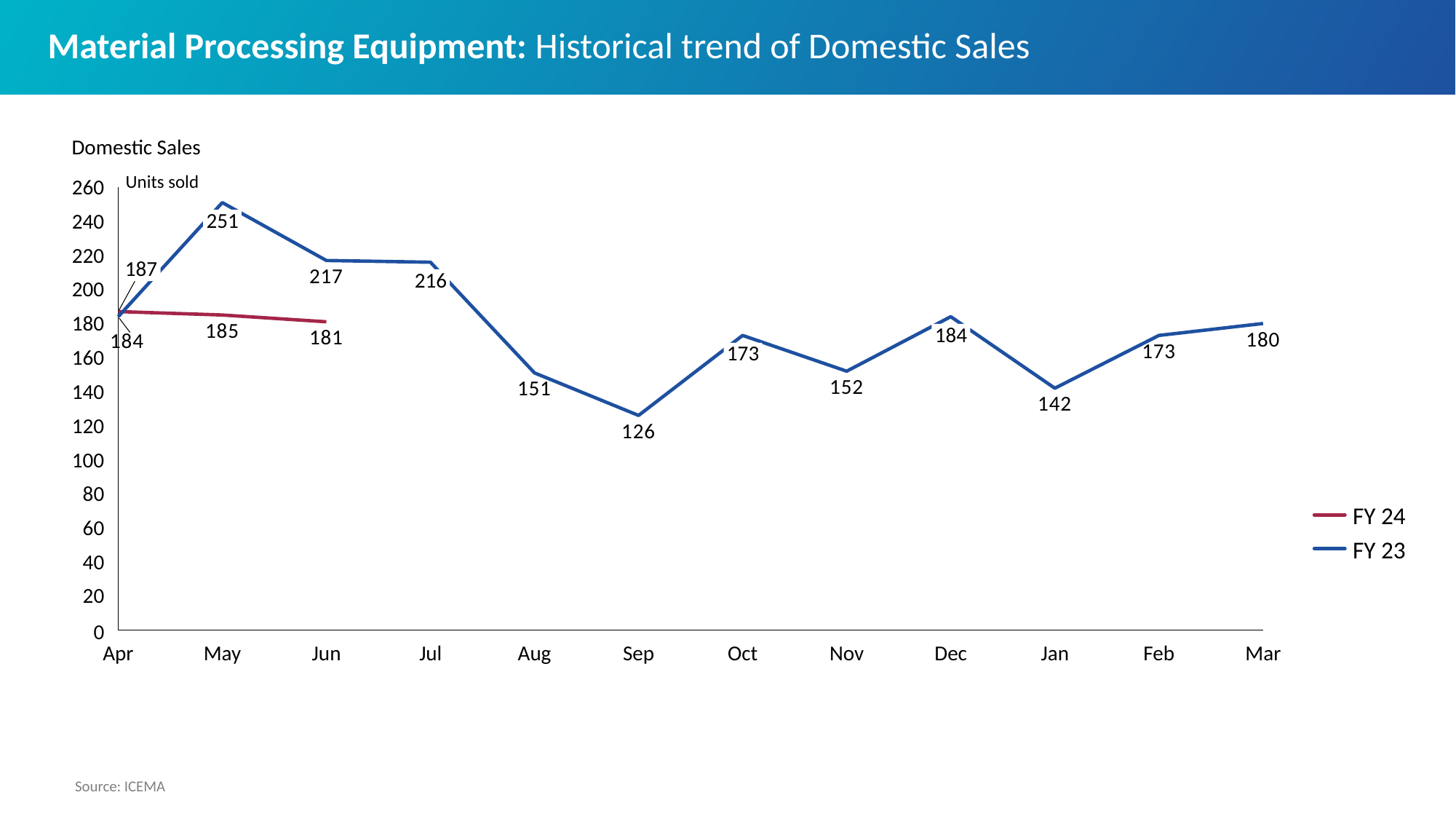
Which is larger, the FY 23 value for Apr or the FY 24 value for Apr? FY 24 Does the FY 24 line rise or fall from Apr to Jun? fall Which month has the highest FY 23 value? May Which month has the lowest FY 23 value? Sep How many series does the legend list? 2 What is the FY 24 value for Jun? 181 What is the difference between the FY 23 values for May and Jun? 34 What is the FY 23 value for Sep? 126 What is the FY 23 value for May? 251 Is the FY 23 value for Jan greater or less than 160? less How many months are shown on the x axis? 12 What kind of chart is shown on the slide? line chart